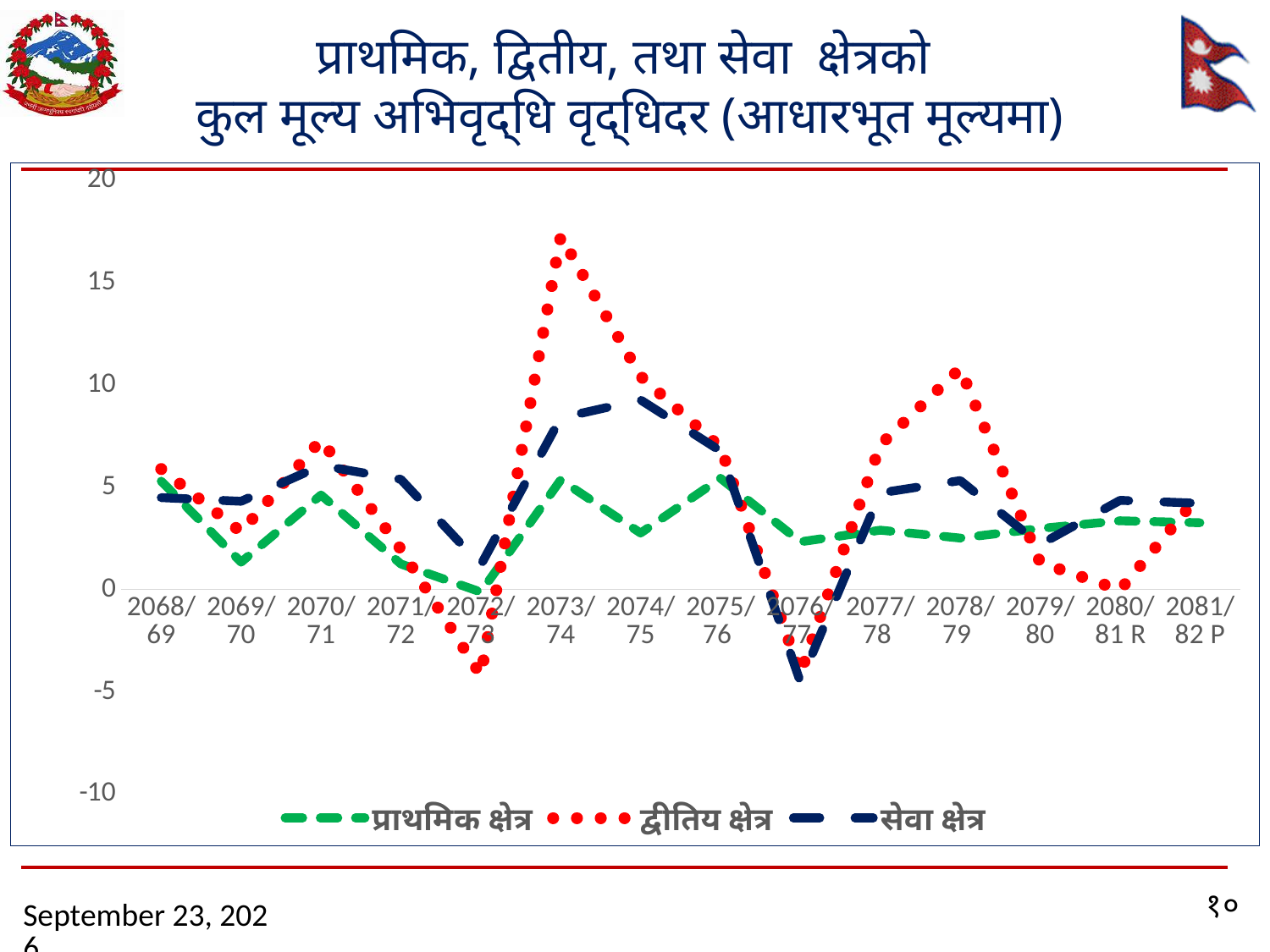
How many fiscal years are plotted along the x axis? 14 In 2069/70, which series has the larger value, सेवा क्षेत्र or प्राथमिक क्षेत्र? सेवा क्षेत्र Is the value for सेवा क्षेत्र in 2076/77 greater or less than 0? less How many series does the legend list? 3 Is the value for द्वीतिय क्षेत्र in 2073/74 greater or less than 15? greater Does the द्वीतिय क्षेत्र series rise or fall from 2073/74 to 2076/77? fall In which fiscal year does the सेवा क्षेत्र series reach its lowest value? 2076/77 What kind of chart is shown on the slide? line chart In which fiscal year does the द्वीतिय क्षेत्र series reach its highest value? 2073/74 In 2073/74, which series has the larger value, द्वीतिय क्षेत्र or प्राथमिक क्षेत्र? द्वीतिय क्षेत्र Which colour is used for the सेवा क्षेत्र series? dark blue (navy) Is the value for प्राथमिक क्षेत्र in 2072/73 greater or less than 5? less